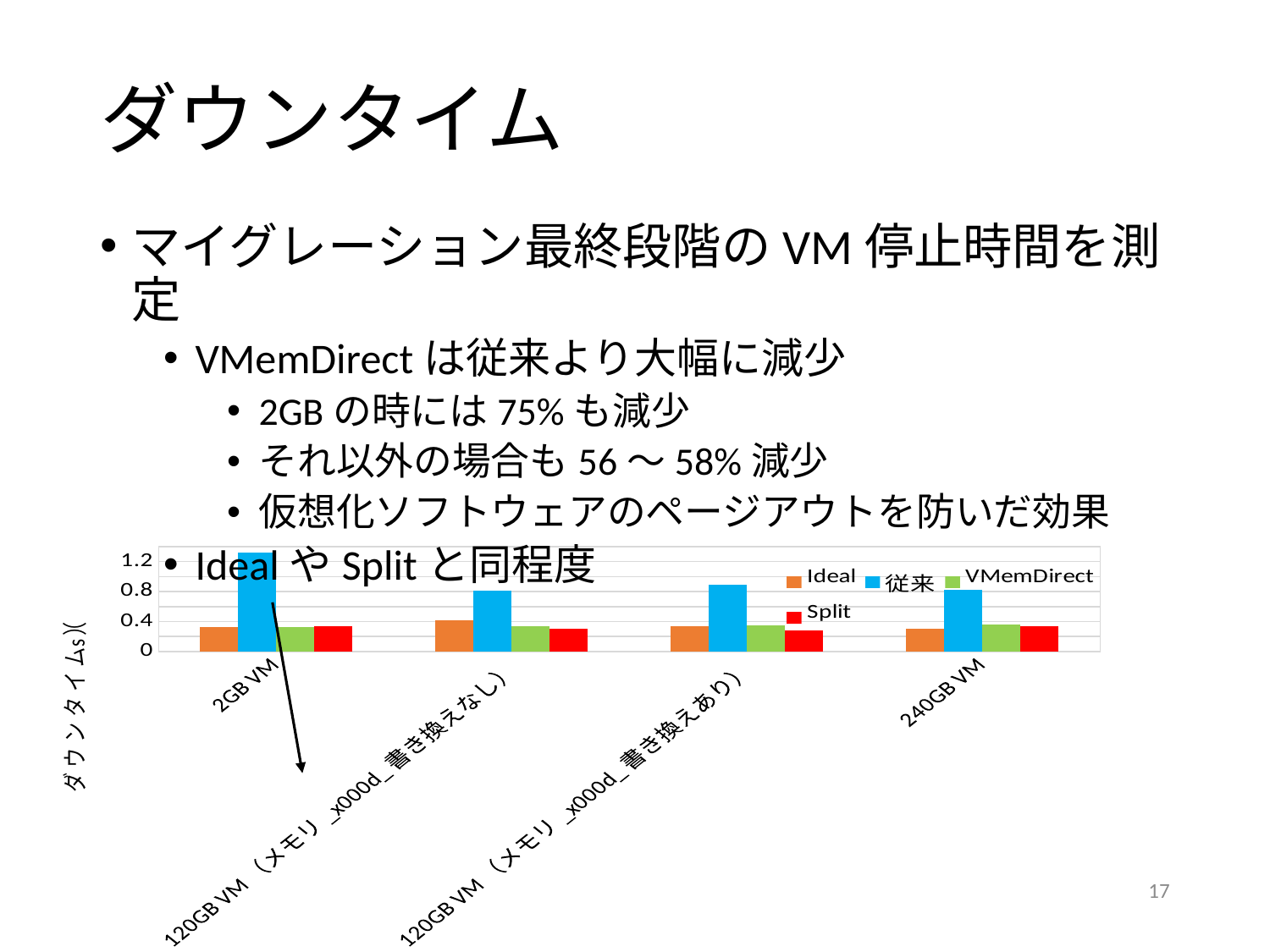
For which category is the 従来 bar the highest? 2GB VM Which series is shown in blue in the chart's legend? 従来 Is the VMemDirect value for 2GB VM greater or less than 0.8? less Which series has the highest bar for 2GB VM? 従来 Is the 従来 value for 2GB VM greater or less than 0.8? greater How many series does the chart's legend list? 4 What kind of chart is shown on the slide? bar chart For 2GB VM, which is larger: the 従来 value or the VMemDirect value? 従来 Is the 従来 value for 240GB VM greater or less than 0.4? greater How many categories are shown on the x axis of the chart? 4 What is the label of the chart's vertical axis? ダウンタイム (s)